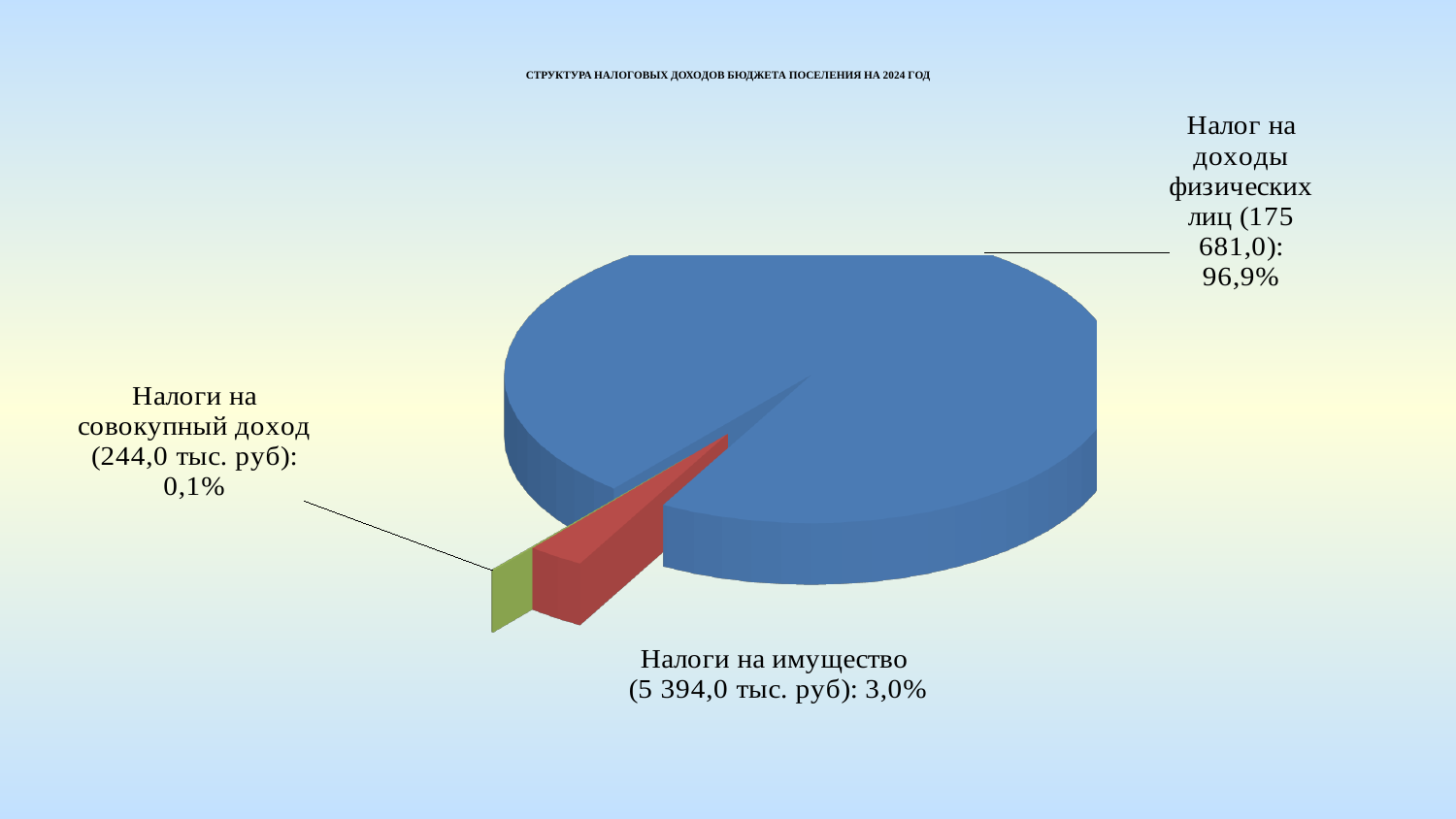
What is the value shown for "Налог на доходы физических лиц"? 175 681,0 Which category has the largest slice of the pie? Налог на доходы физических лиц What kind of chart is shown on the slide? pie chart What share of the pie does "Налог на доходы физических лиц" represent? 96,9% How many slices does the pie chart have? 3 What is the title of the chart? СТРУКТУРА НАЛОГОВЫХ ДОХОДОВ БЮДЖЕТА ПОСЕЛЕНИЯ НА 2024 ГОД Which is larger, the share for "Налоги на имущество" or the share for "Налоги на совокупный доход"? Налоги на имущество What is the value shown for "Налоги на совокупный доход"? 244,0 тыс. руб What is the value shown for "Налоги на имущество"? 5 394,0 тыс. руб Which category has the smallest slice of the pie? Налоги на совокупный доход What share of the pie does "Налоги на совокупный доход" represent? 0,1% What share of the pie does "Налоги на имущество" represent? 3,0%